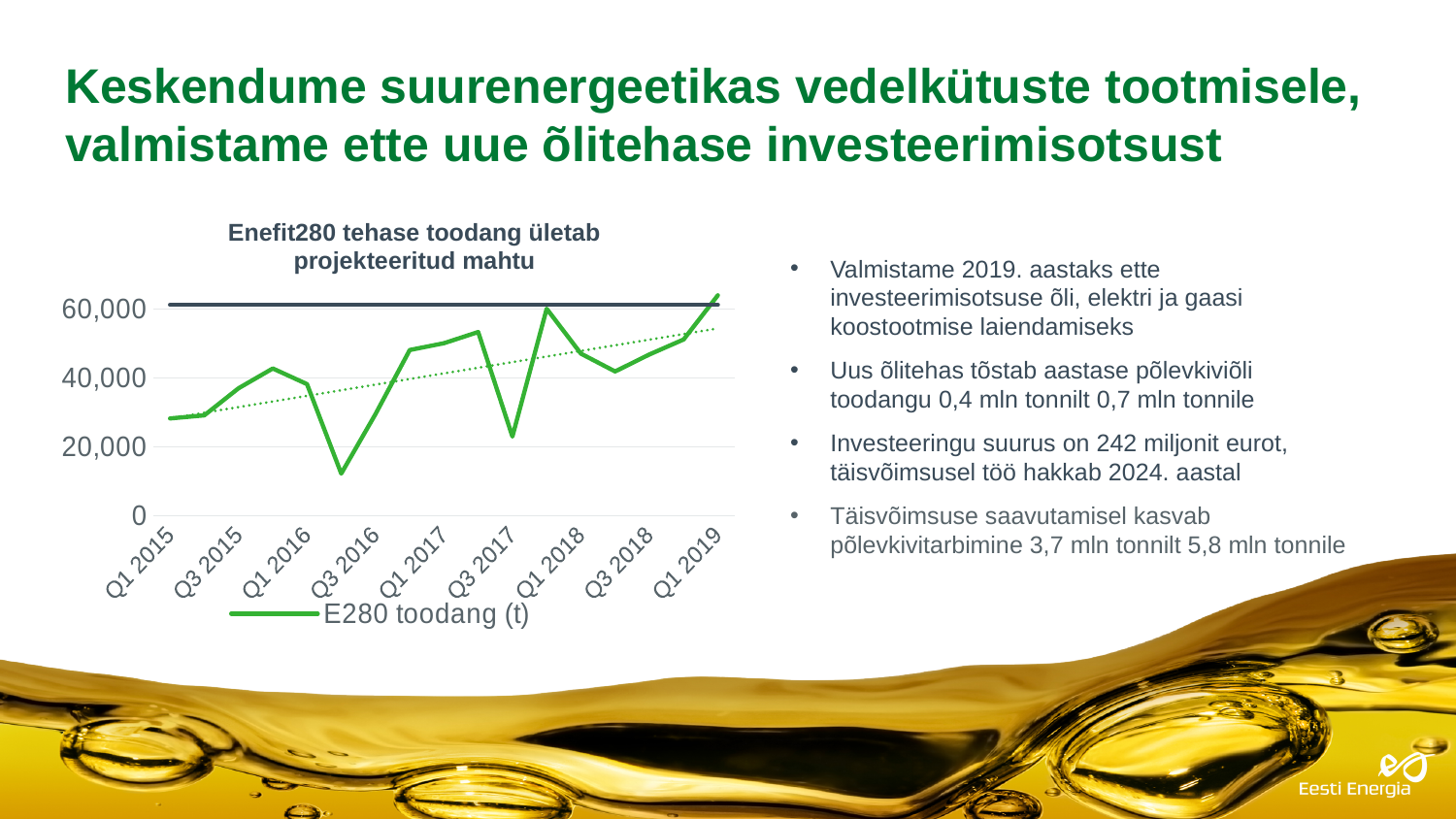
How many series does the legend list? 1 What kind of chart is shown on the slide? line chart Which is larger, the value for Q1 2015 or the value for Q1 2019? Q1 2019 Does the E280 toodang (t) line generally rise or fall from Q1 2015 to Q1 2019? rise Is the value for Q1 2015 greater or less than 40,000? less How many labels are shown on the x axis of the chart? 9 Is the value for Q3 2017 greater or less than 40,000? less Which labeled quarter has the highest value on the chart? Q1 2019 Is the value for Q1 2019 greater or less than 60,000? greater What is the title of the chart? Enefit280 tehase toodang ületab projekteeritud mahtu What series name does the chart legend show? E280 toodang (t)